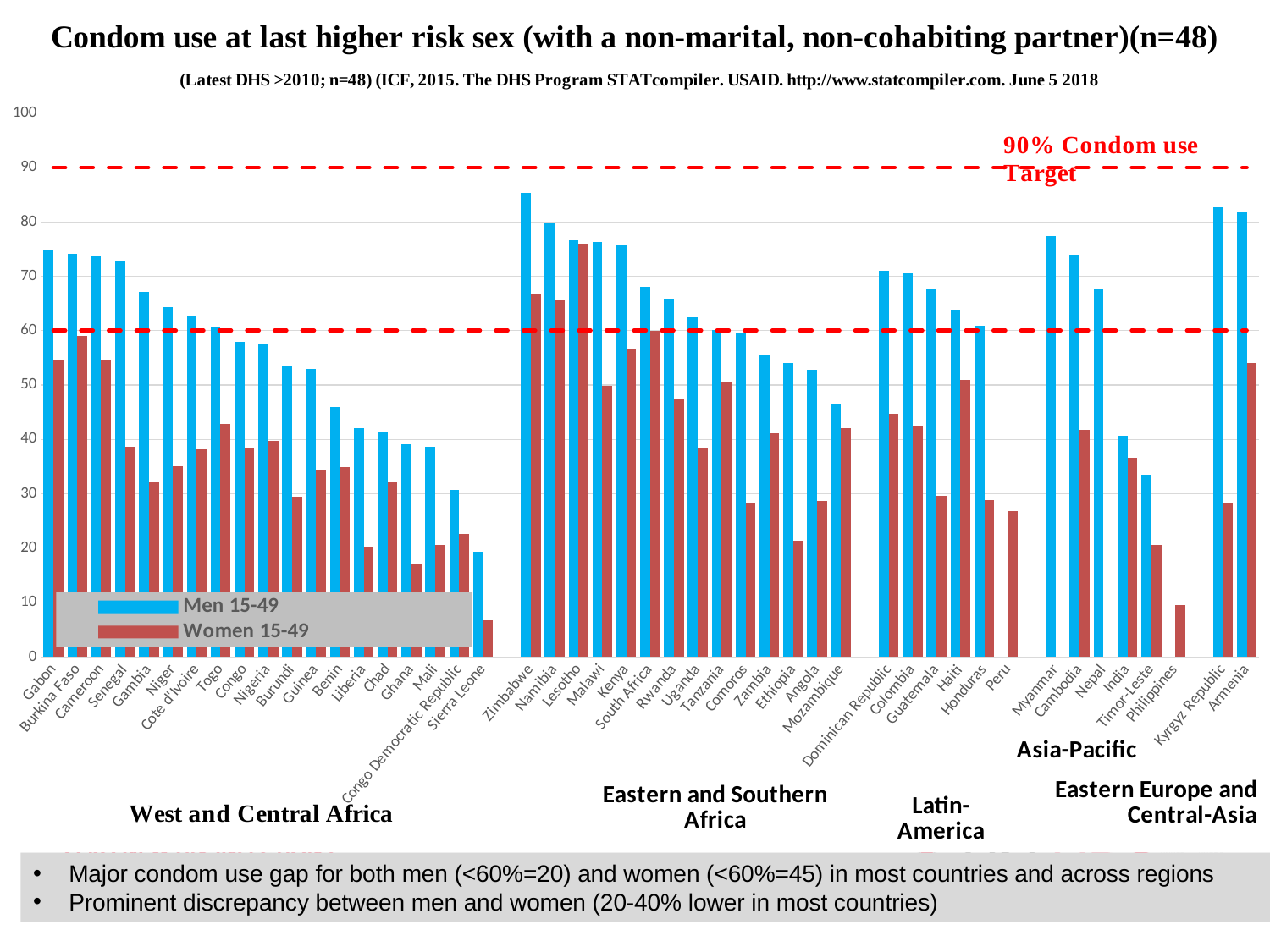
Is the Men 15-49 value for Gabon greater or less than 70? greater What are the two series named in the legend? Men 15-49 and Women 15-49 Is the Women 15-49 value for Ghana greater or less than 20? less Which country has the highest value for Men 15-49? Zimbabwe How many series does the legend list? 2 What target level does the upper red dashed line mark? 90% Condom use Target Which is larger, the Women 15-49 value for Lesotho or the Women 15-49 value for Zimbabwe? Lesotho Is the Women 15-49 value for Sierra Leone greater or less than 10? less Which is larger, the Men 15-49 value for Zimbabwe or the Men 15-49 value for Gabon? Zimbabwe What kind of chart is shown on the slide? bar chart Which country has the lowest value for Women 15-49? Sierra Leone